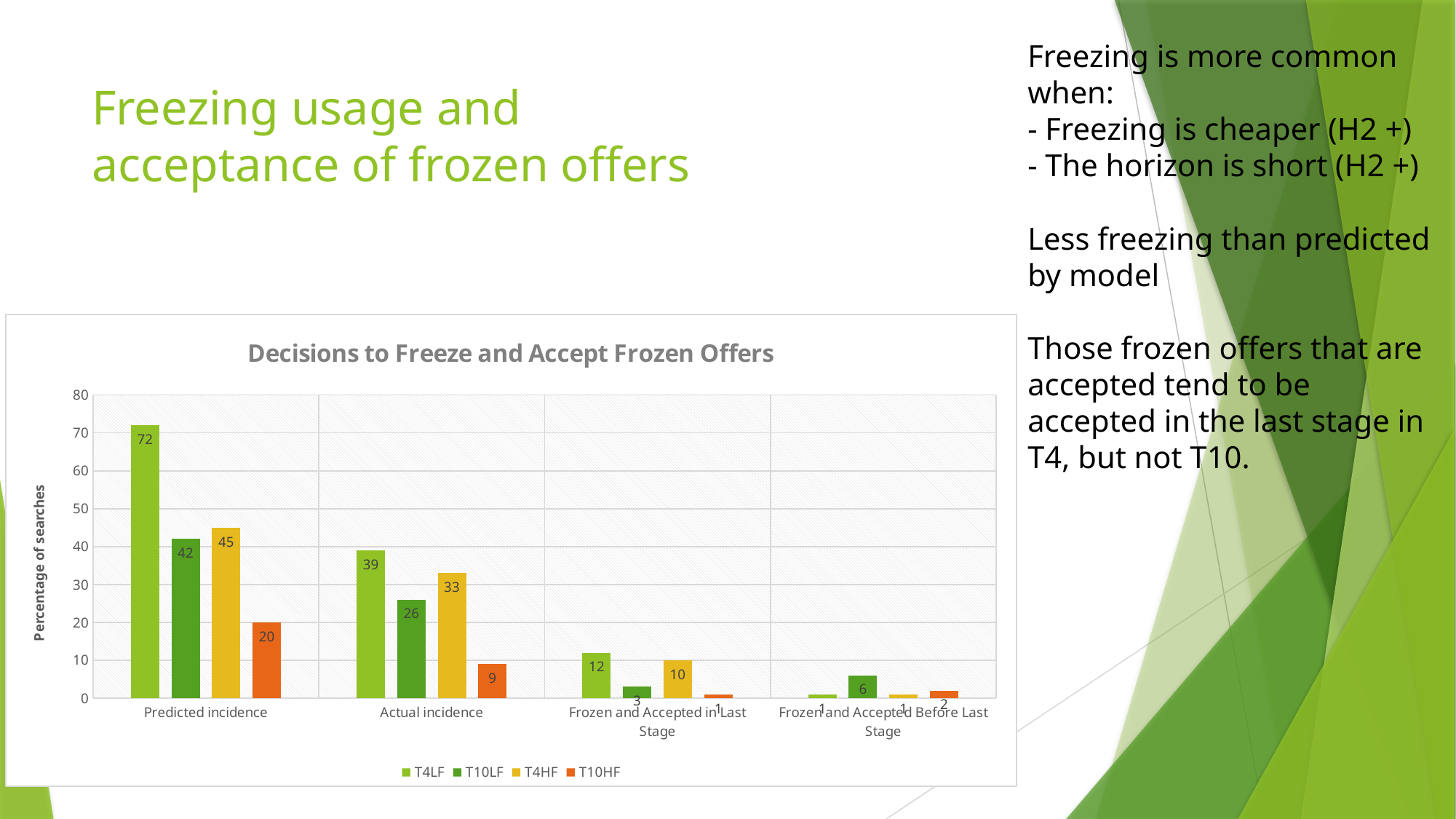
What is the value for T10HF in the Actual incidence category? 9 What is the label of the y axis of the chart? Percentage of searches How many series does the chart legend list? 4 What is the difference between the T4LF values for Predicted incidence and Actual incidence? 33 Which series has the lowest value in the Predicted incidence category? T10HF Which series has the highest value in the Actual incidence category? T4LF What is the value for T4HF in the Predicted incidence category? 45 Which is larger in the Actual incidence category: T10LF or T4HF? T4HF How many categories are shown on the x axis of the chart? 4 What type of chart is shown on the slide? bar chart What is the value for T4LF in the Predicted incidence category? 72 What is the title of the chart? Decisions to Freeze and Accept Frozen Offers